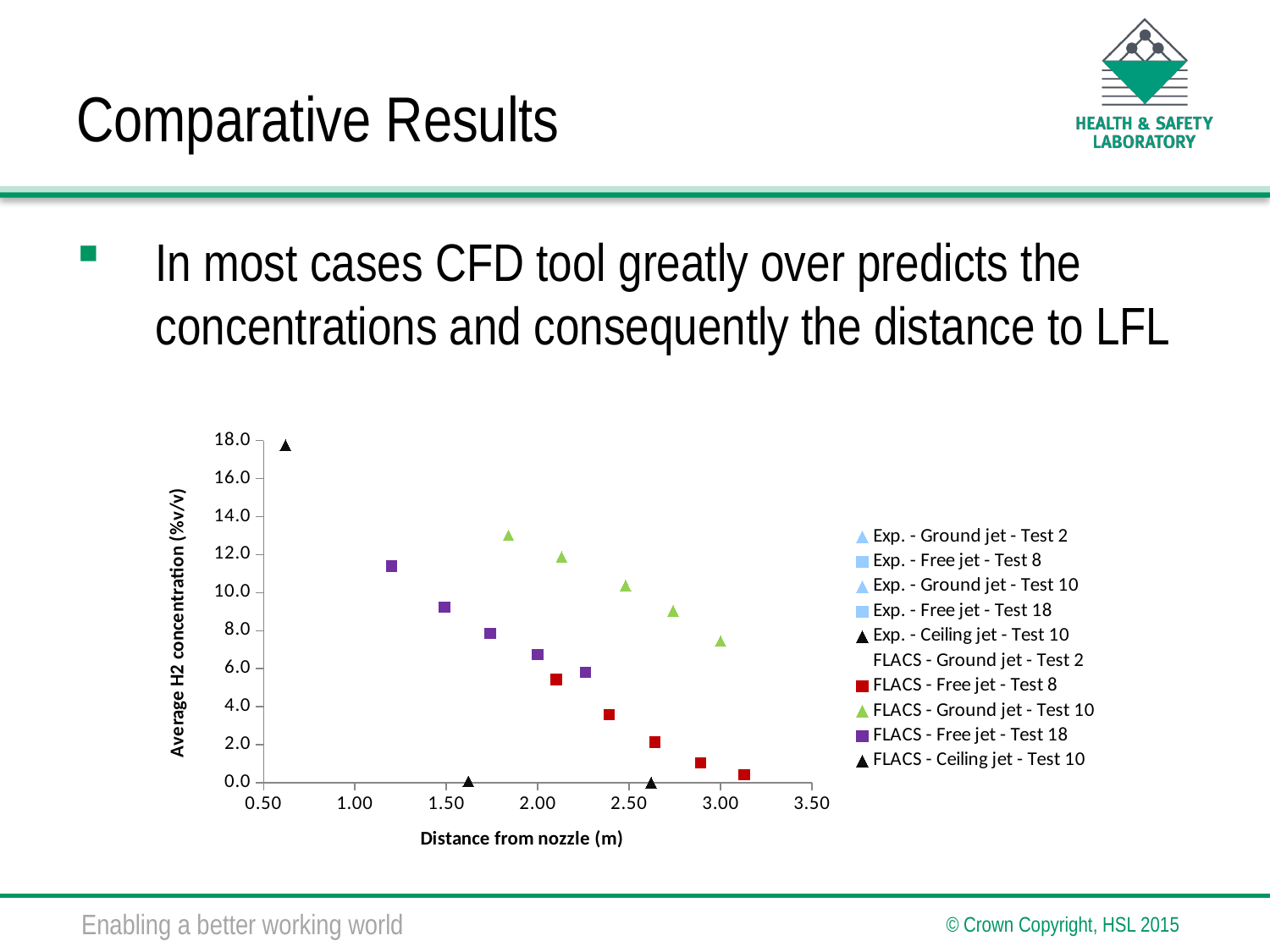
How many points are plotted for the FLACS - Free jet - Test 8 series? 5 What is the title of the y axis of the chart? Average H2 concentration (%v/v) At a distance of about 2.25 m, which series has the larger value: FLACS - Ground jet - Test 10 or FLACS - Free jet - Test 18? FLACS - Ground jet - Test 10 Is the value of the FLACS - Ceiling jet - Test 10 point nearest the y axis greater or less than 16.0? greater Is the value of the FLACS - Ground jet - Test 10 point at about 3.00 m greater or less than 8.0? less What kind of chart is shown on the slide? Scatter chart Which series contains the highest plotted point on the chart? FLACS - Ceiling jet - Test 10 What is the title of the x axis of the chart? Distance from nozzle (m) How many series does the chart legend list? 10 Is the value of the FLACS - Free jet - Test 8 point furthest from the nozzle greater or less than 2.0? less Do the plotted H2 concentrations rise or fall as the distance from the nozzle increases? Fall